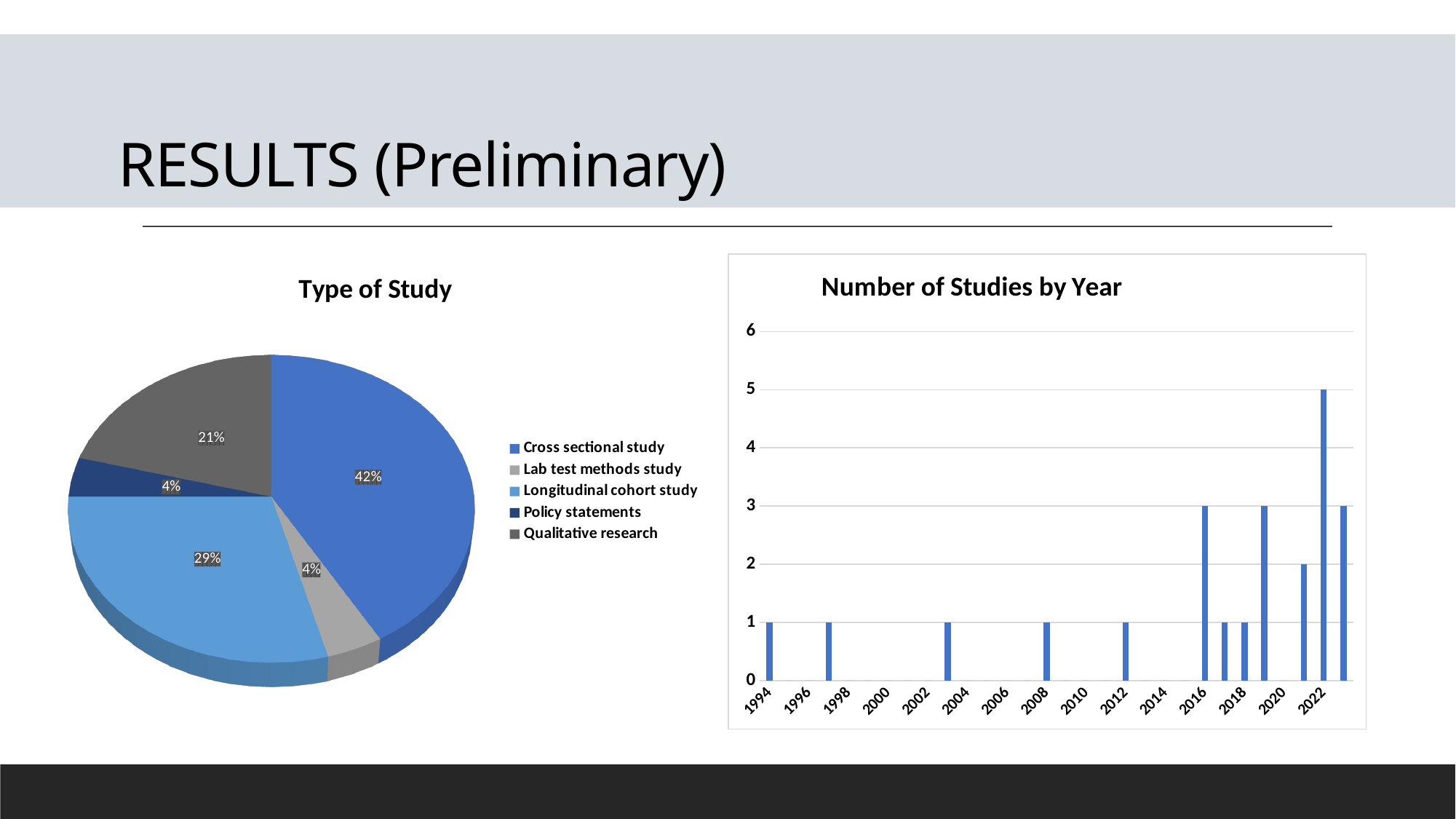
What type of chart is the "Type of Study" chart? pie chart In the "Type of Study" pie chart, which category has the largest share? Cross sectional study In the "Type of Study" pie chart, what share is Qualitative research? 21% In the "Number of Studies by Year" chart, how many studies are shown for 2016? 3 In the "Number of Studies by Year" chart, which year has the highest number of studies? 2022 In the "Type of Study" pie chart, what is the difference between the Cross sectional study share and the Longitudinal cohort study share? 13% In the "Number of Studies by Year" chart, how many studies are shown for 2022? 5 In the "Type of Study" pie chart, what share is Cross sectional study? 42% In the "Type of Study" pie chart, what share is Longitudinal cohort study? 29% In the "Type of Study" pie chart, how many categories does the legend list? 5 What type of chart is "Number of Studies by Year"? bar chart In the "Number of Studies by Year" chart, which is larger, the value for 2022 or the value for 2016? 2022